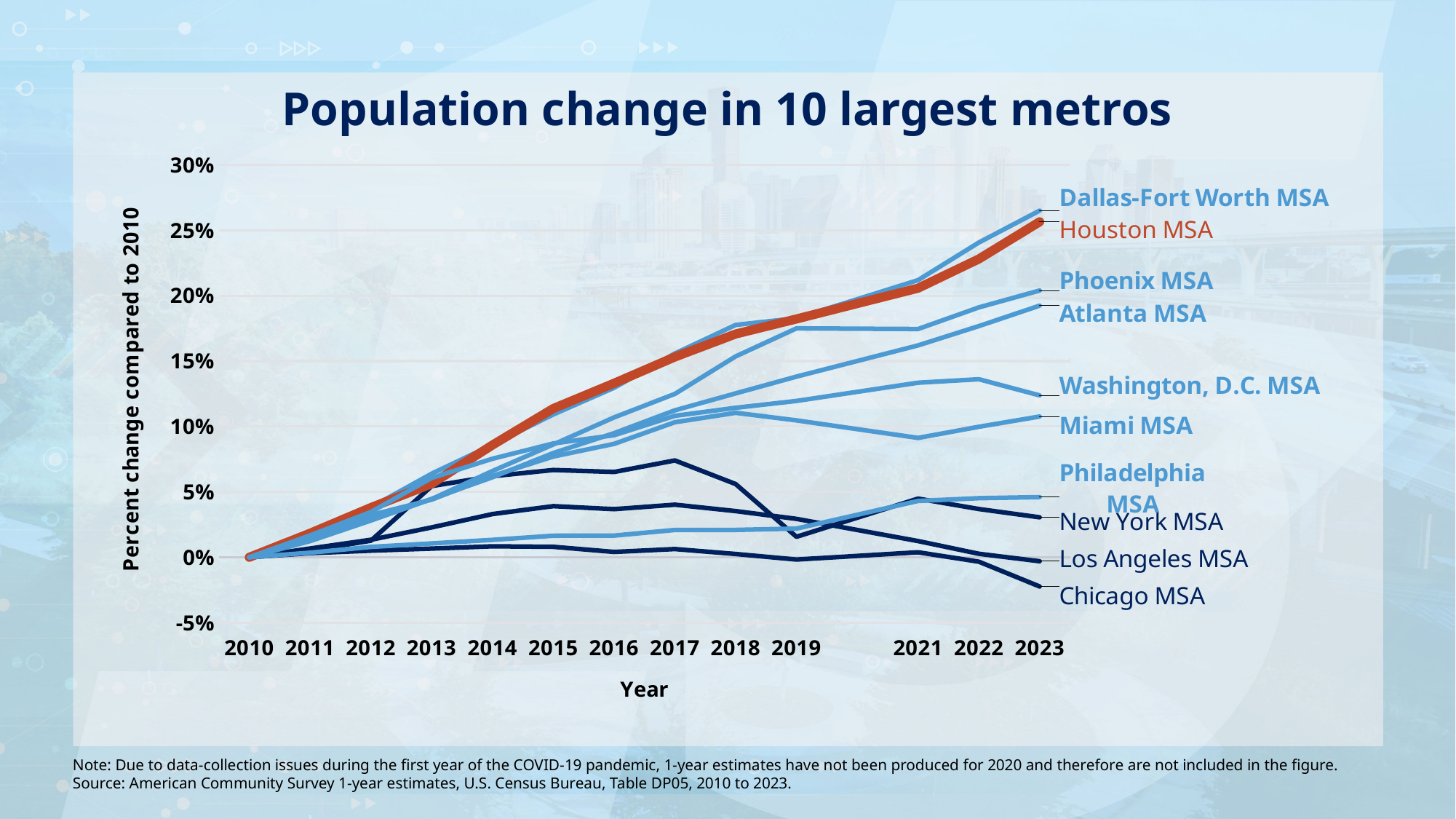
Is the value for Atlanta MSA in 2023 greater or less than 20%? less Is the value for Washington, D.C. MSA in 2023 greater or less than 10%? greater How many years are plotted along the x axis? 13 What kind of chart is shown on the slide? line chart Which metro area has the lowest percent change in 2023? Chicago MSA Which metro area's line is drawn in orange-red on the chart? Houston MSA Is the value for Chicago MSA in 2023 greater or less than 0%? less In 2023, which is larger: the value for Houston MSA or the value for Phoenix MSA? Houston MSA How many metro areas (series) are plotted on the chart? 10 Which metro area has the highest percent change in 2023? Dallas-Fort Worth MSA Does the value for Dallas-Fort Worth MSA rise or fall from 2010 to 2023? rise